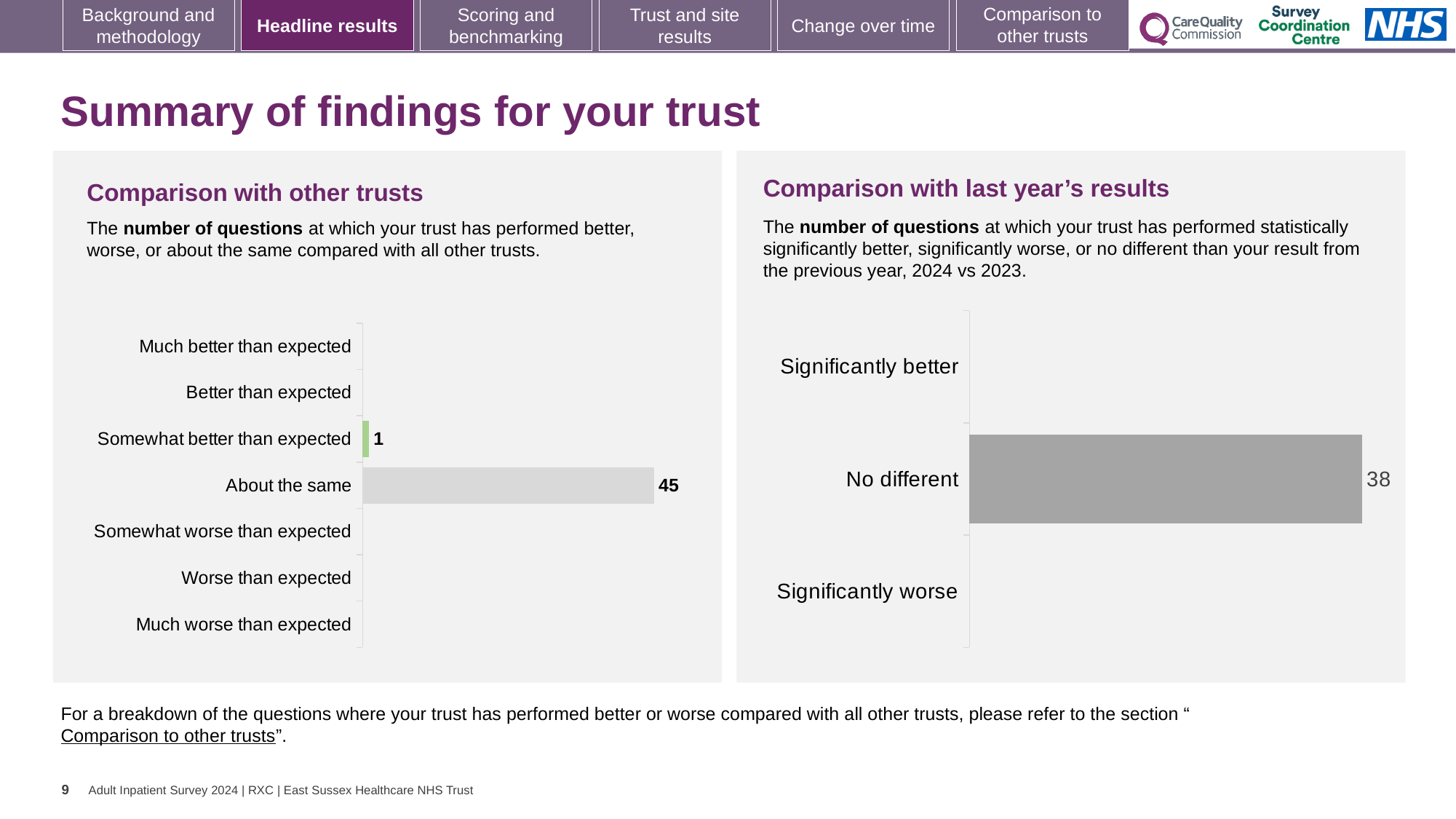
What kind of chart is the 'Comparison with other trusts' chart? Bar chart In the 'Comparison with other trusts' chart, how many questions are 'About the same'? 45 In the 'Comparison with other trusts' chart, how many questions are 'Somewhat better than expected'? 1 In the 'Comparison with other trusts' chart, which is larger: 'About the same' or 'Somewhat better than expected'? About the same In the 'Comparison with other trusts' chart, which category has the highest value? About the same In the 'Comparison with other trusts' chart, how many categories are listed on the axis? 7 In the 'Comparison with other trusts' chart, what colour is the 'Somewhat better than expected' bar? Green In the 'Comparison with other trusts' chart, what is the difference between 'About the same' and 'Somewhat better than expected'? 44 In the 'Comparison with last year's results' chart, which category has the highest value? No different In the 'Comparison with last year's results' chart, how many questions are 'No different'? 38 What kind of chart is the 'Comparison with last year's results' chart? Bar chart In the 'Comparison with last year's results' chart, how many categories are listed on the axis? 3